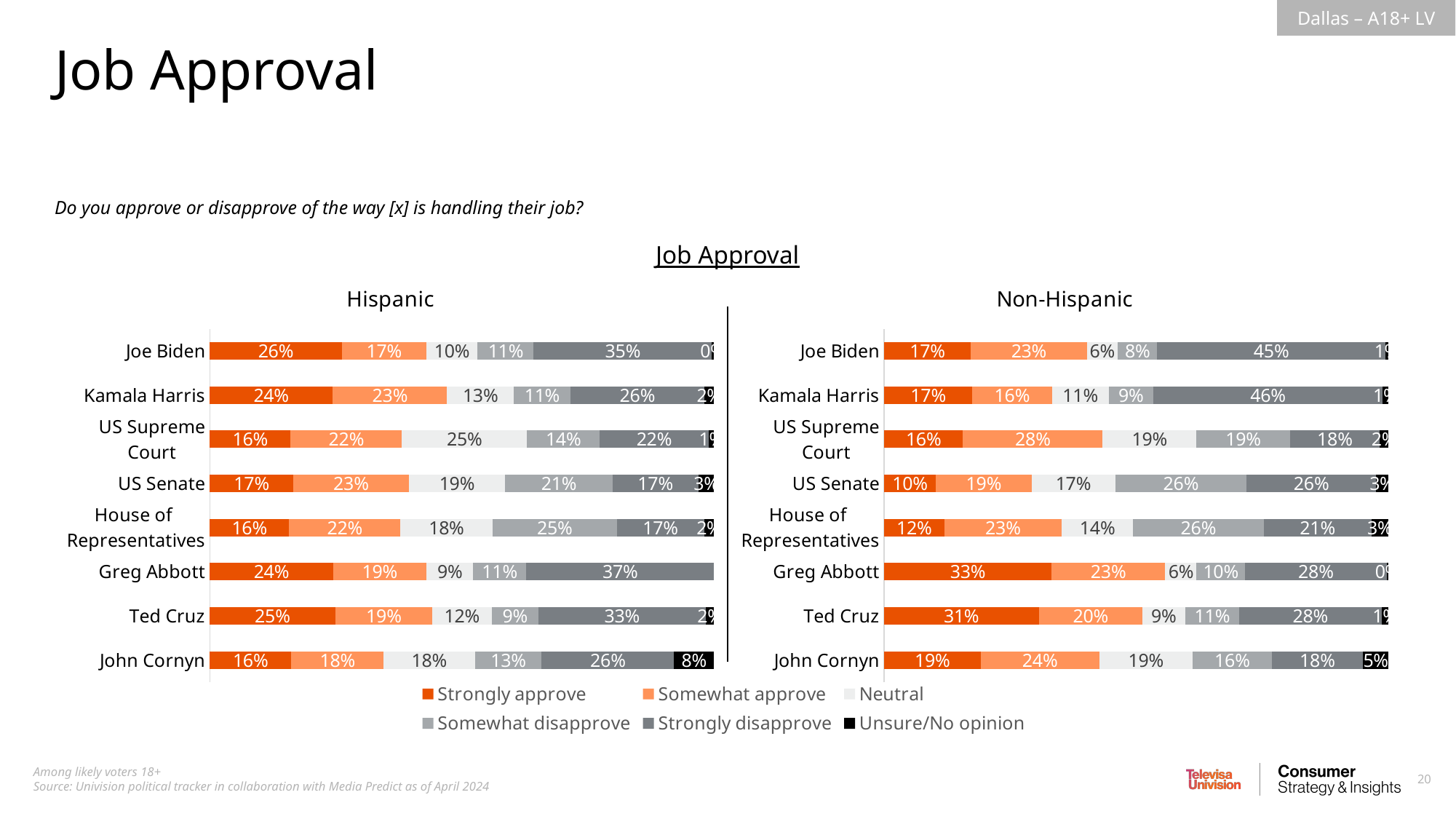
How many series does the legend list? 6 Which legend entry is shown in black? Unsure/No opinion In the Hispanic chart, what is the Unsure/No opinion value for John Cornyn? 8% In the Non-Hispanic chart, which person or institution has the lowest Strongly approve value? US Senate What is the difference between the Strongly disapprove value for Joe Biden in the Non-Hispanic chart and in the Hispanic chart? 10 percentage points How many people or institutions are listed in the Hispanic chart? 8 In the Hispanic chart, is the Strongly disapprove value larger for Greg Abbott or for Ted Cruz? Greg Abbott In the Non-Hispanic chart, what percentage somewhat approve of the US Supreme Court? 28% In the Non-Hispanic chart, what percentage strongly disapprove of Kamala Harris? 46% In the Non-Hispanic chart, which person or institution has the highest Strongly approve value? Greg Abbott In the Hispanic chart, what percentage strongly approve of Joe Biden? 26% What kind of chart is used to show the Job Approval data? Stacked bar chart